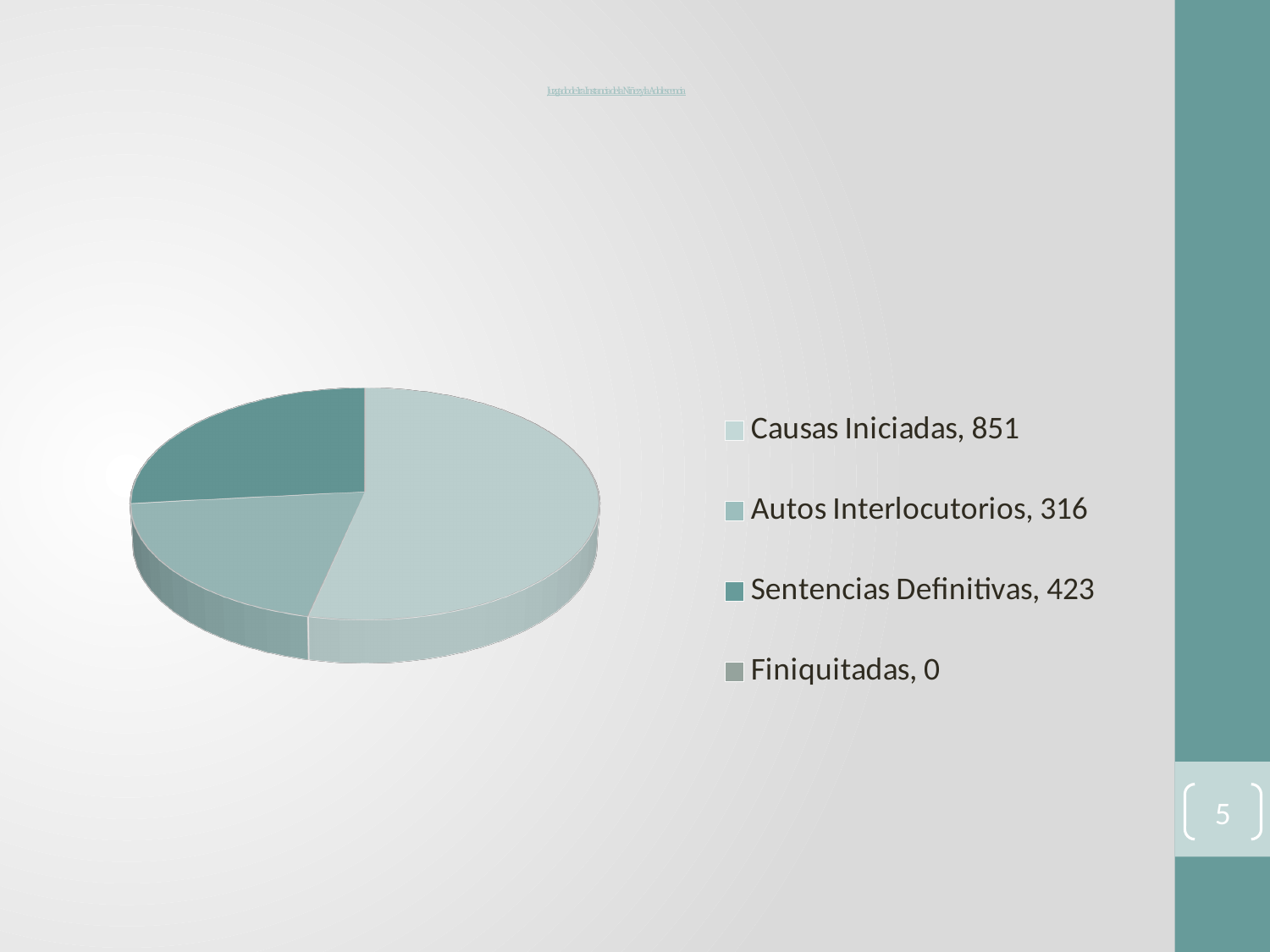
Which category has the lowest value in the pie chart? Finiquitadas What is the value for Sentencias Definitivas in the pie chart? 423 Which category has the highest value in the pie chart? Causas Iniciadas What is the value for Finiquitadas in the pie chart? 0 What is the difference between Sentencias Definitivas and Autos Interlocutorios? 107 What is the value for Causas Iniciadas in the pie chart? 851 How many categories does the legend of the pie chart list? 4 What is the difference between Causas Iniciadas and Sentencias Definitivas? 428 What is the total of all the values listed in the pie chart legend? 1590 Which is larger, Autos Interlocutorios or Sentencias Definitivas? Sentencias Definitivas What kind of chart is shown on the slide? Pie chart What is the value for Autos Interlocutorios in the pie chart? 316